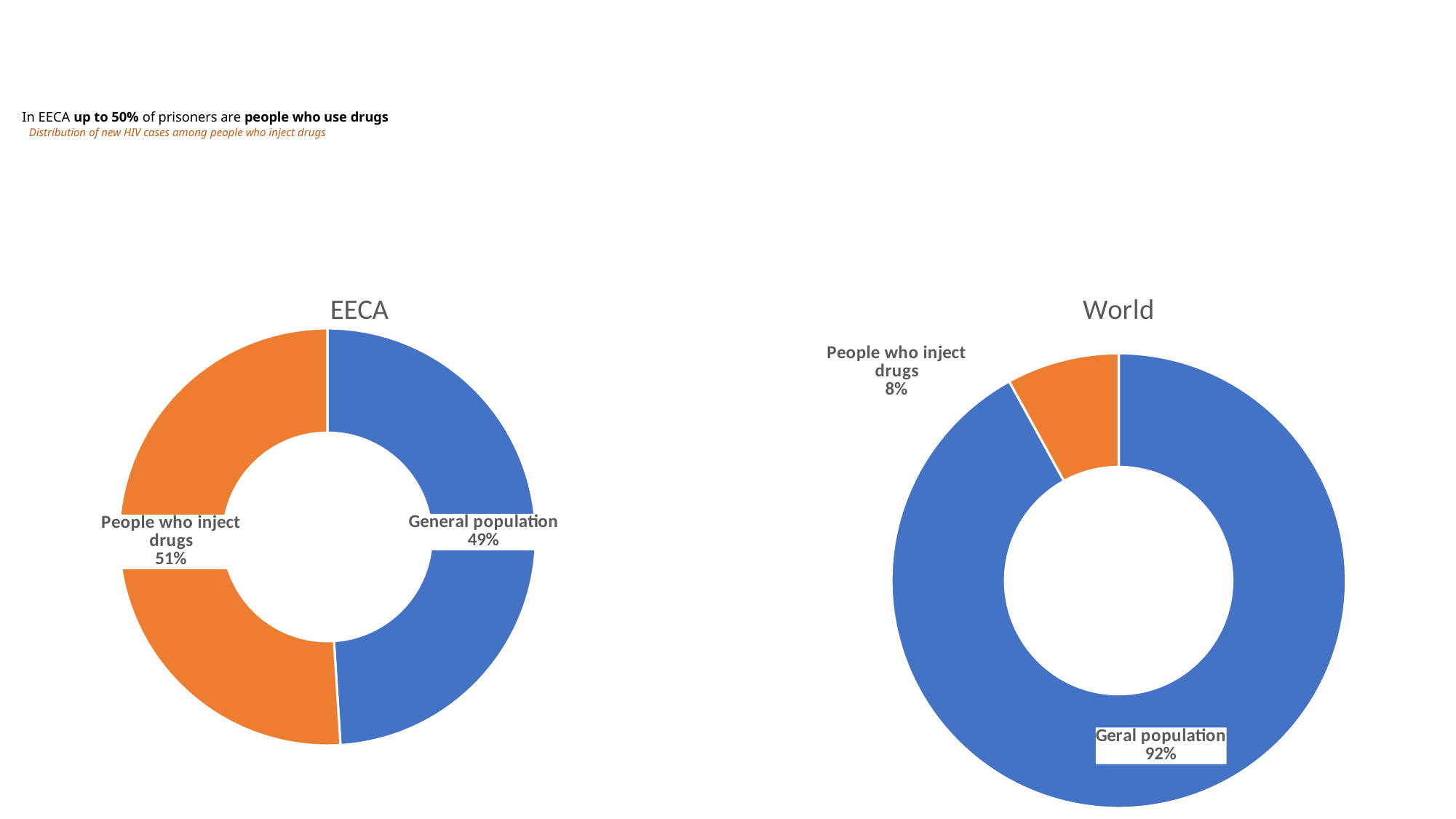
In the EECA chart, what is the difference between the people who inject drugs share and the general population share? 2% In the World chart, what is the difference between the general population share and the people who inject drugs share? 84% In the World chart, is the share for the general population larger or smaller than the share for people who inject drugs? larger In the World chart, which category has the smallest share? People who inject drugs In the EECA chart, what share of new HIV cases is attributed to people who inject drugs? 51% In the EECA chart, what share is attributed to the general population? 49% In the World chart, which category has the largest share? Geral population What colour represents people who inject drugs in both charts? Orange In the World chart, what share is attributed to the general population? 92% What type of chart is the World chart? Doughnut (pie) chart In the World chart, what share of new HIV cases is attributed to people who inject drugs? 8% How many categories does the EECA chart show? 2